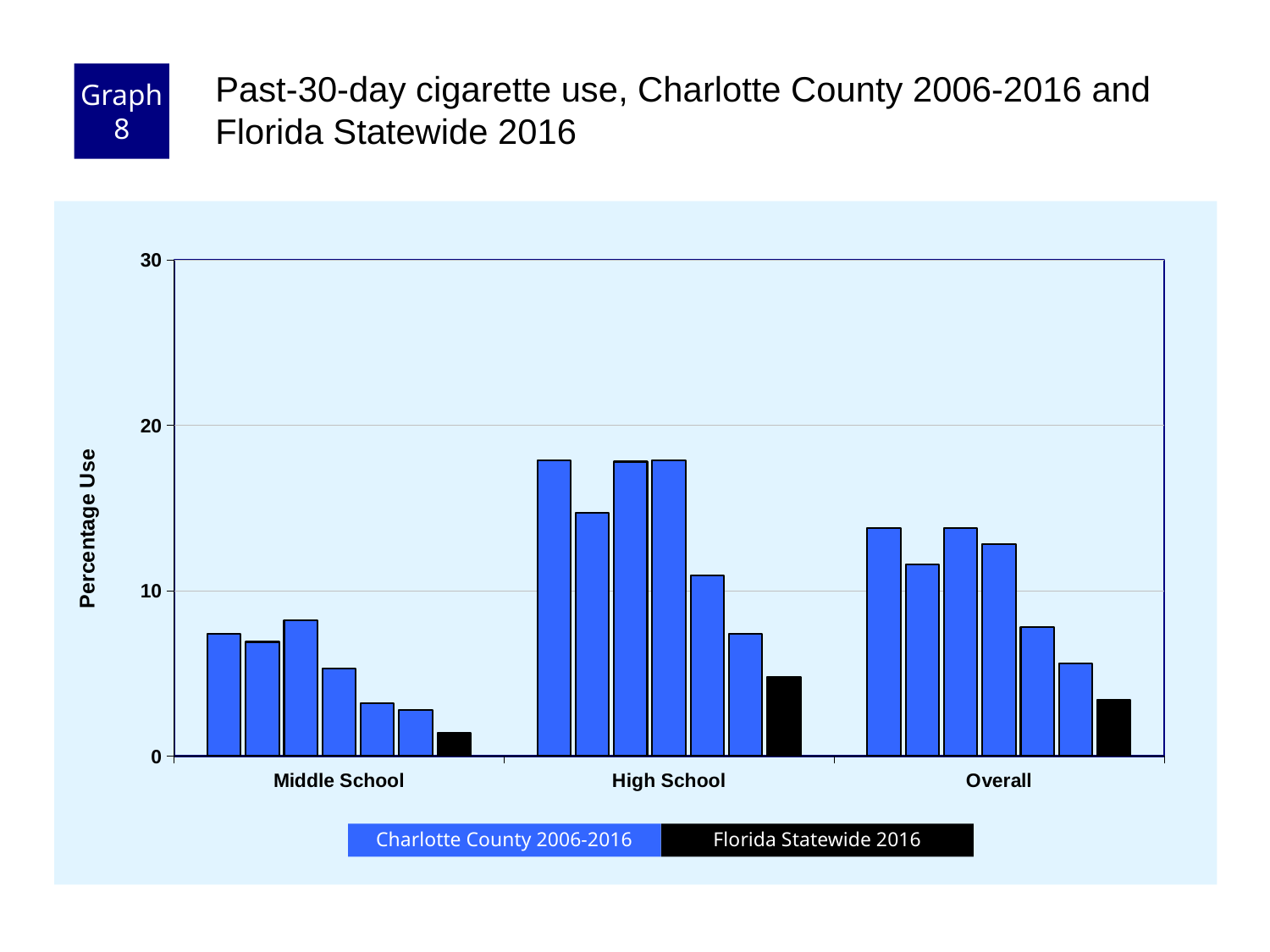
Is the tallest Charlotte County 2006-2016 bar for High School greater or less than 20? less Which category has the lowest Florida Statewide 2016 value? Middle School What is the label on the y axis? Percentage Use Is the Florida Statewide 2016 value for High School greater or less than 10? less Is the Florida Statewide 2016 value larger for High School or for Overall? High School Within the Overall category, do the Charlotte County 2006-2016 bars generally rise or fall from left to right? fall How many categories are shown on the x axis? 3 Which category has the highest Florida Statewide 2016 value? High School Is the Florida Statewide 2016 value for Middle School greater or less than 10? less What kind of chart is shown on the slide? bar chart How many series does the legend list? 2